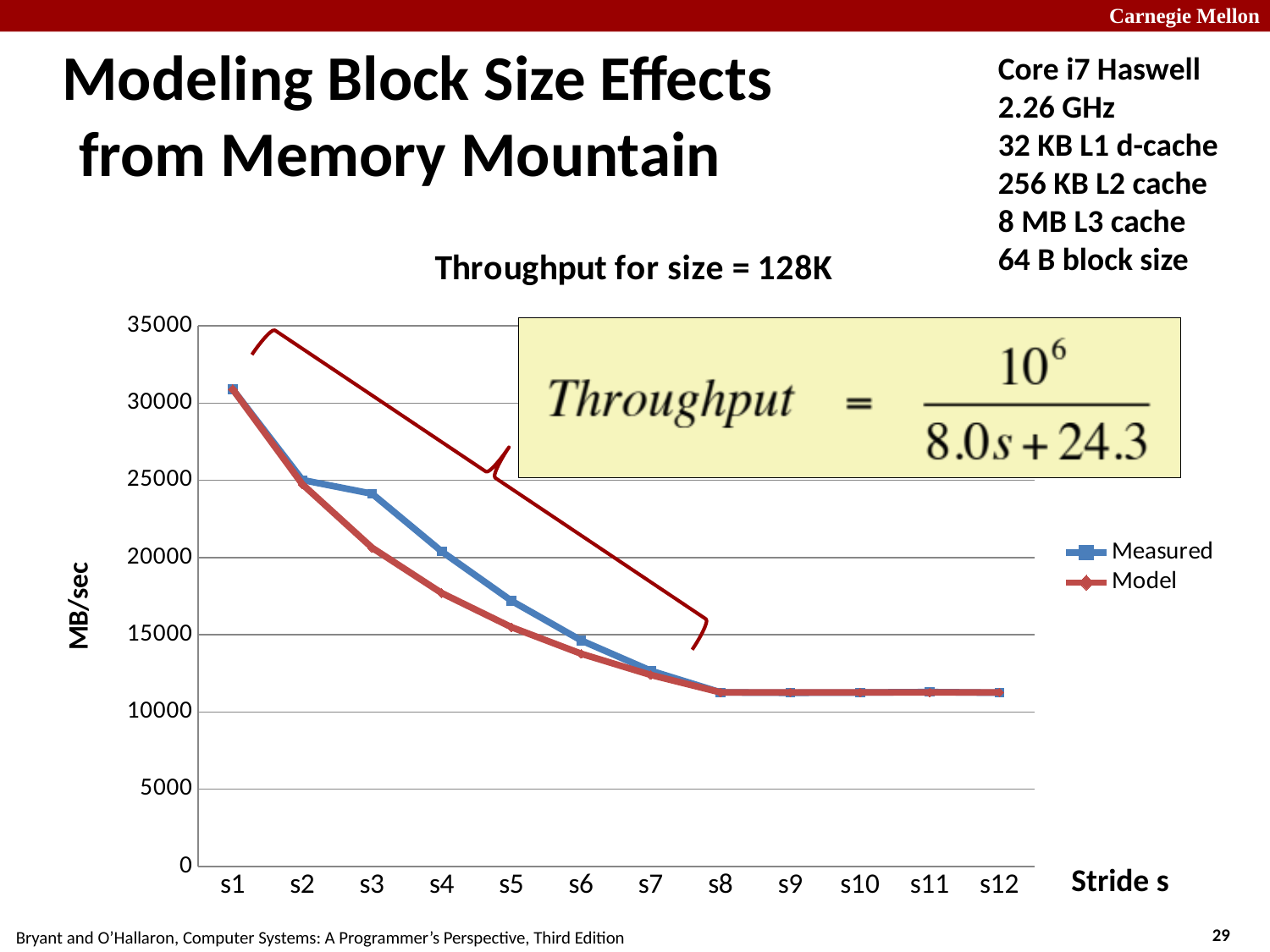
At stride s3, which series has the larger value, Measured or Model? Measured Is the Model value at s4 greater or less than 20000? less How many series does the legend list? 2 How many stride values are plotted along the x axis? 12 What are the names of the two series in the legend? Measured and Model Is the Measured value at s3 greater or less than 25000? less What is the title of the chart? Throughput for size = 128K At which stride is the Measured throughput highest? s1 What kind of chart is shown on the slide? line chart Is the Measured value at s5 greater or less than 20000? less